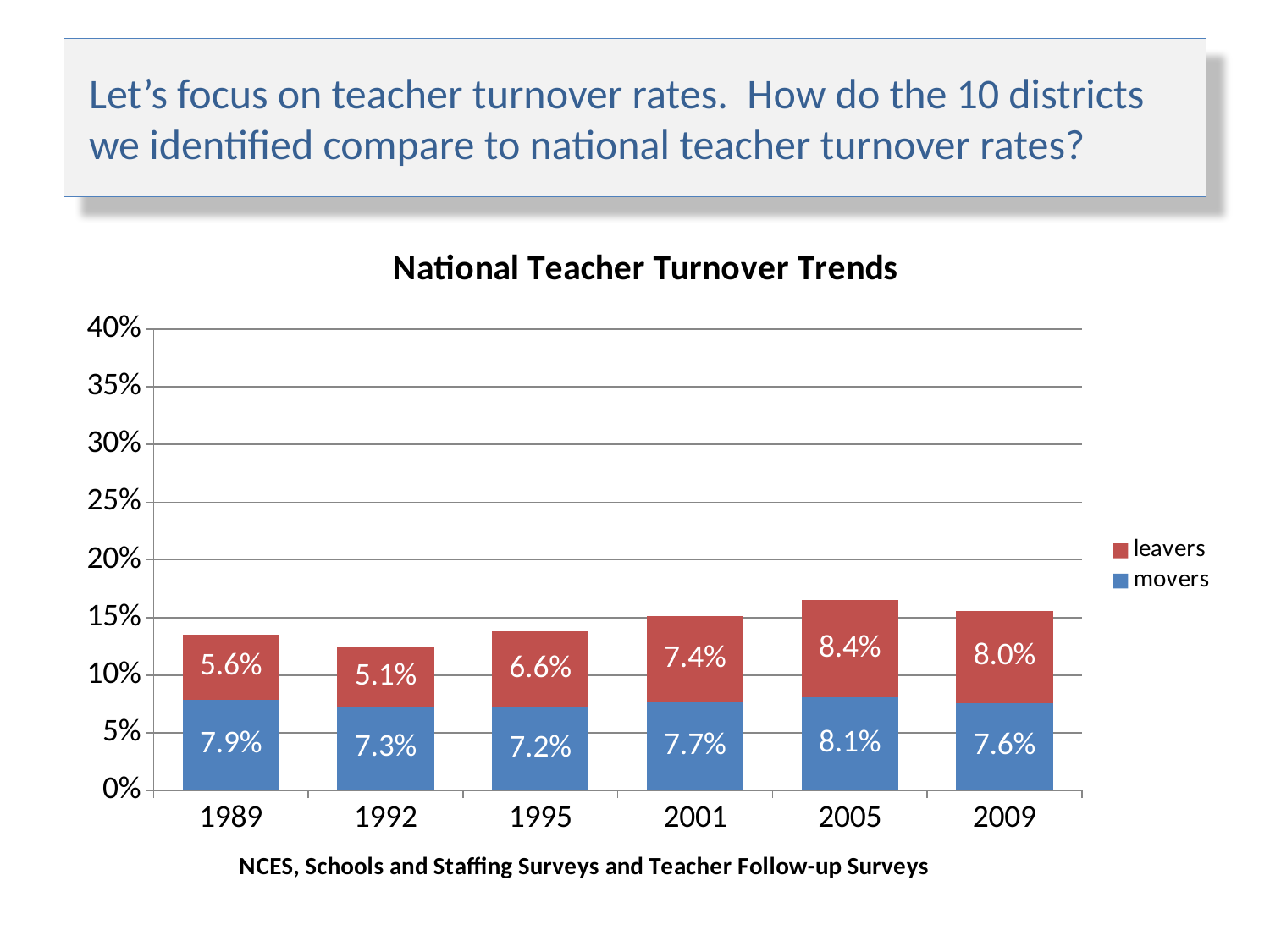
What is the total of the stacked bar for 1992? 12.4% Which is larger, the movers value in 1989 or the movers value in 1992? 1989 How many years are shown on the x axis? 6 What is the total of the stacked bar for 2005? 16.5% Which year has the highest value for leavers? 2005 How many series does the legend list? 2 Which year has the lowest value for movers? 1995 What is the value for movers in 2005? 8.1% What is the difference between the leavers values for 2005 and 1989? 2.8% What is the value for leavers in 1992? 5.1% What is the value for leavers in 2009? 8.0% What kind of chart is shown on the slide? Stacked bar chart